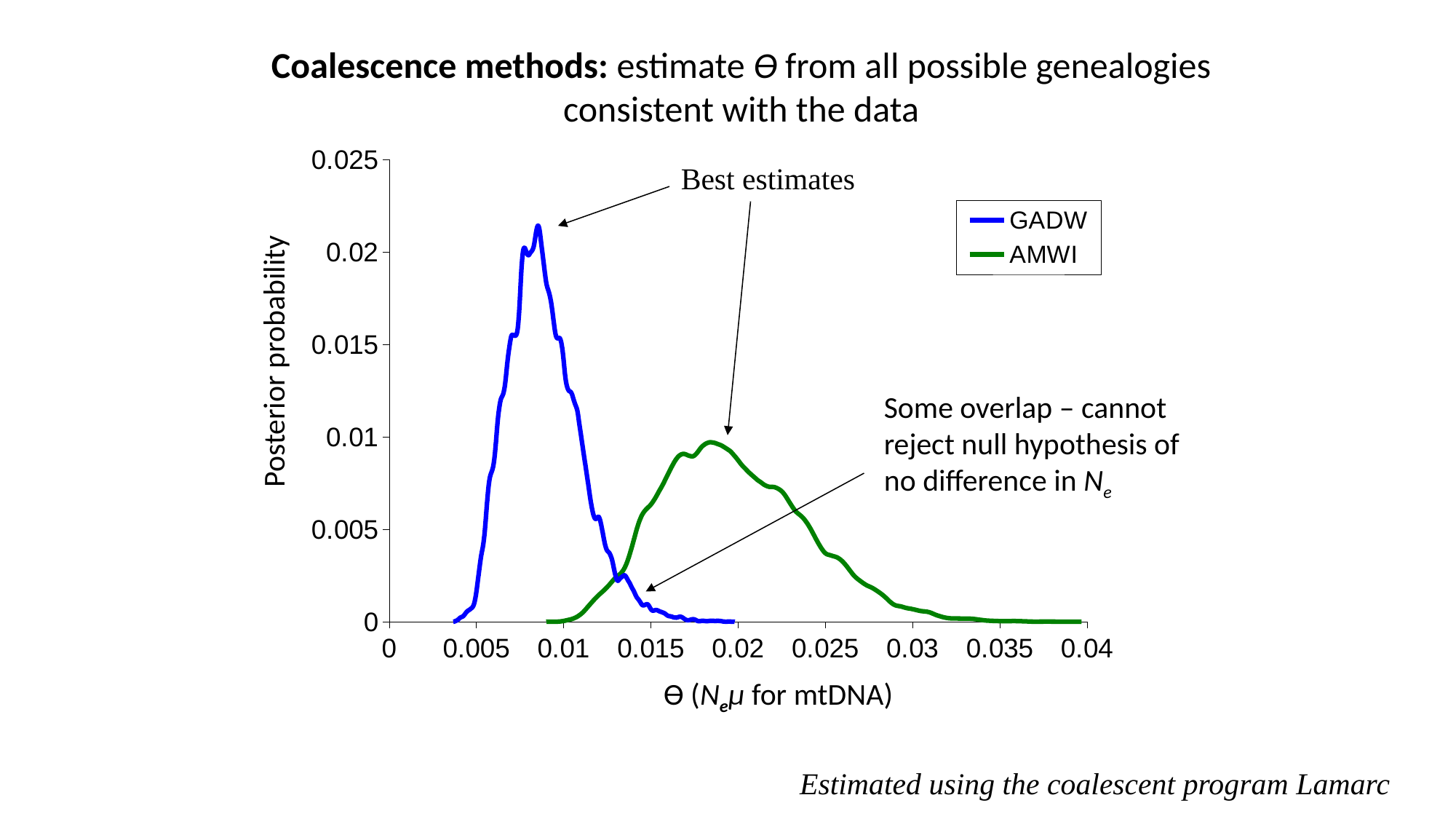
What is the maximum value shown on the x axis? 0.04 Is the Θ value at which the GADW curve peaks greater or less than 0.01? less What kind of chart is shown on the slide? line chart Which series peaks at a larger value of Θ, GADW or AMWI? AMWI Which series has the higher peak posterior probability, GADW or AMWI? GADW What is the label of the y axis? Posterior probability How many series does the legend list? 2 What colour is the AMWI line? green Is the peak posterior probability of the AMWI curve greater or less than 0.015? less Is the Θ value at which the AMWI curve peaks greater or less than 0.015? greater